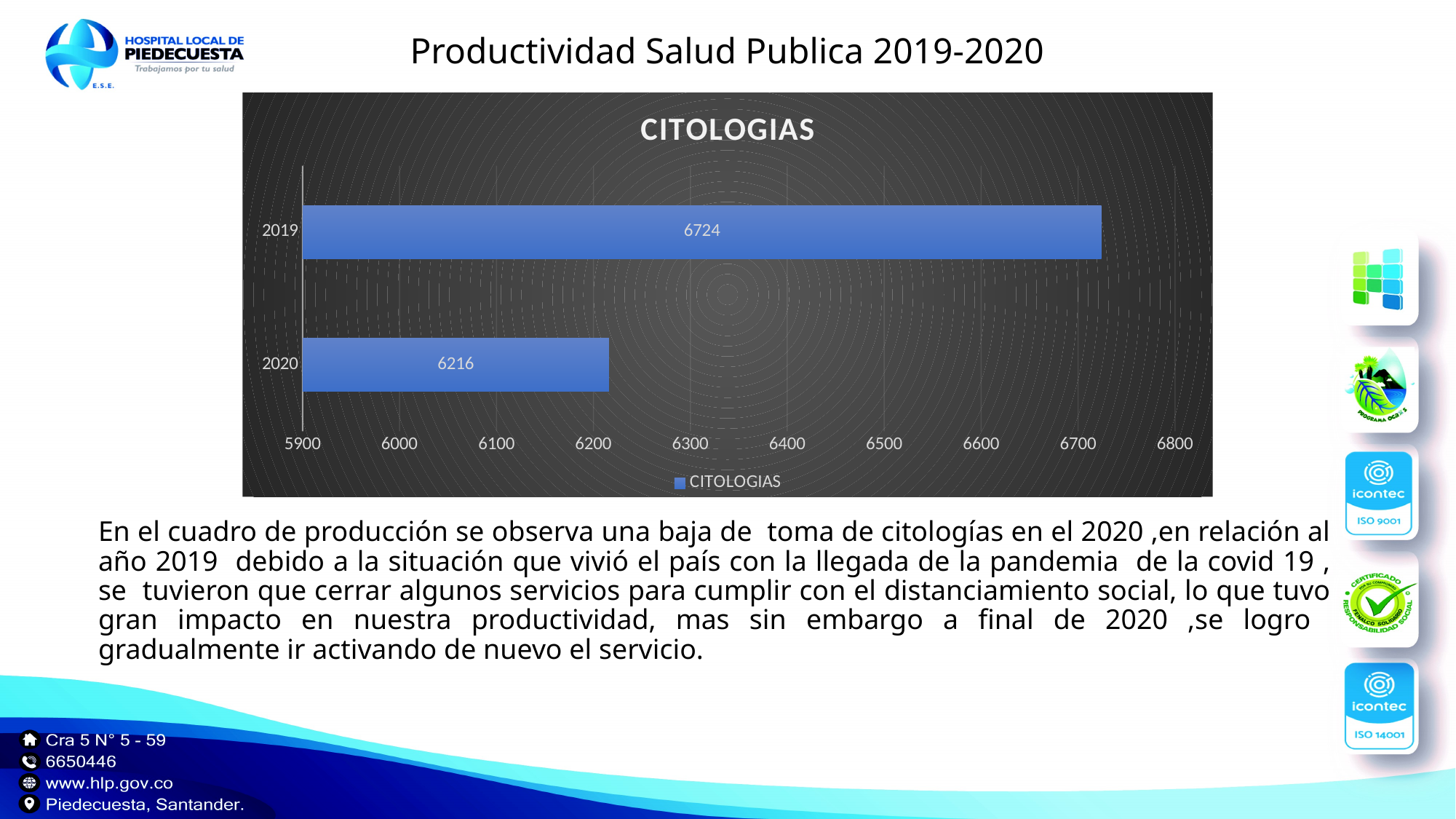
How many categories (years) are shown in the CITOLOGIAS chart? 2 What kind of chart is the CITOLOGIAS chart? Bar chart Which is larger in the CITOLOGIAS chart, the value for 2019 or for 2020? 2019 Which year has the lowest value in the CITOLOGIAS chart? 2020 How many series does the legend of the CITOLOGIAS chart list? 1 What is the value for 2020 in the CITOLOGIAS chart? 6216 Is the value for 2019 in the CITOLOGIAS chart greater or less than 6600? greater Is the value for 2020 in the CITOLOGIAS chart greater or less than 6300? less What is the title of the chart on the slide? CITOLOGIAS What is the value for 2019 in the CITOLOGIAS chart? 6724 What is the difference between the 2019 and 2020 values in the CITOLOGIAS chart? 508 Which year has the highest value in the CITOLOGIAS chart? 2019